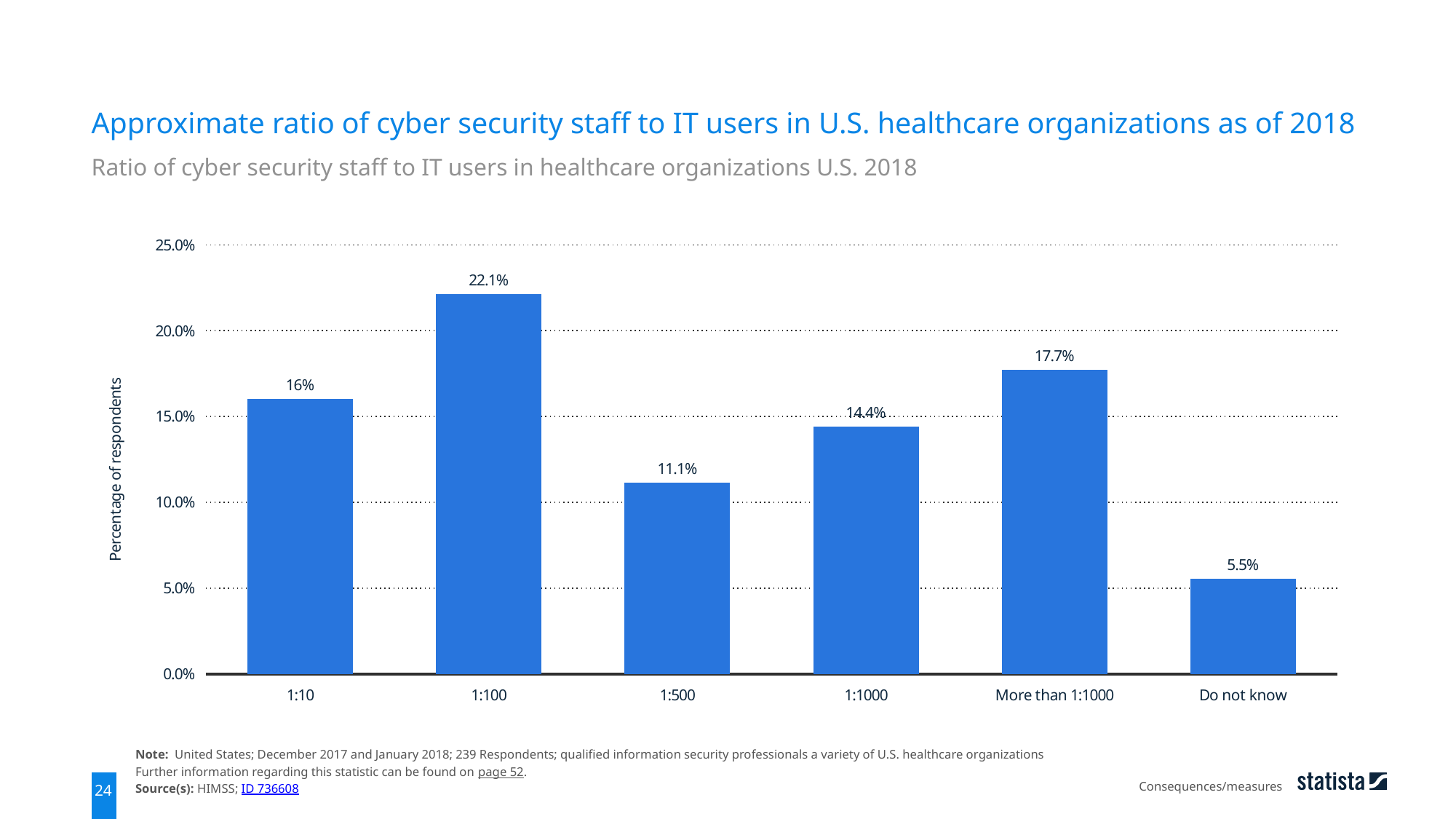
What is the difference in percentage points between the 1:100 and 1:500 categories? 11 percentage points What percentage of respondents answered 'Do not know'? 5.5% What percentage of respondents reported a ratio of more than 1:1000? 17.7% Is the value for 1:500 greater or less than 10.0%? greater How many categories are shown on the x axis? 6 What type of chart is shown on the slide? Bar chart What percentage of respondents reported a ratio of 1:10? 16% What percentage of respondents reported a ratio of 1:100? 22.1% What is the label of the y axis? Percentage of respondents Which has a higher percentage of respondents: 1:1000 or More than 1:1000? More than 1:1000 Which ratio category has the highest percentage of respondents? 1:100 Which category has the lowest percentage of respondents? Do not know